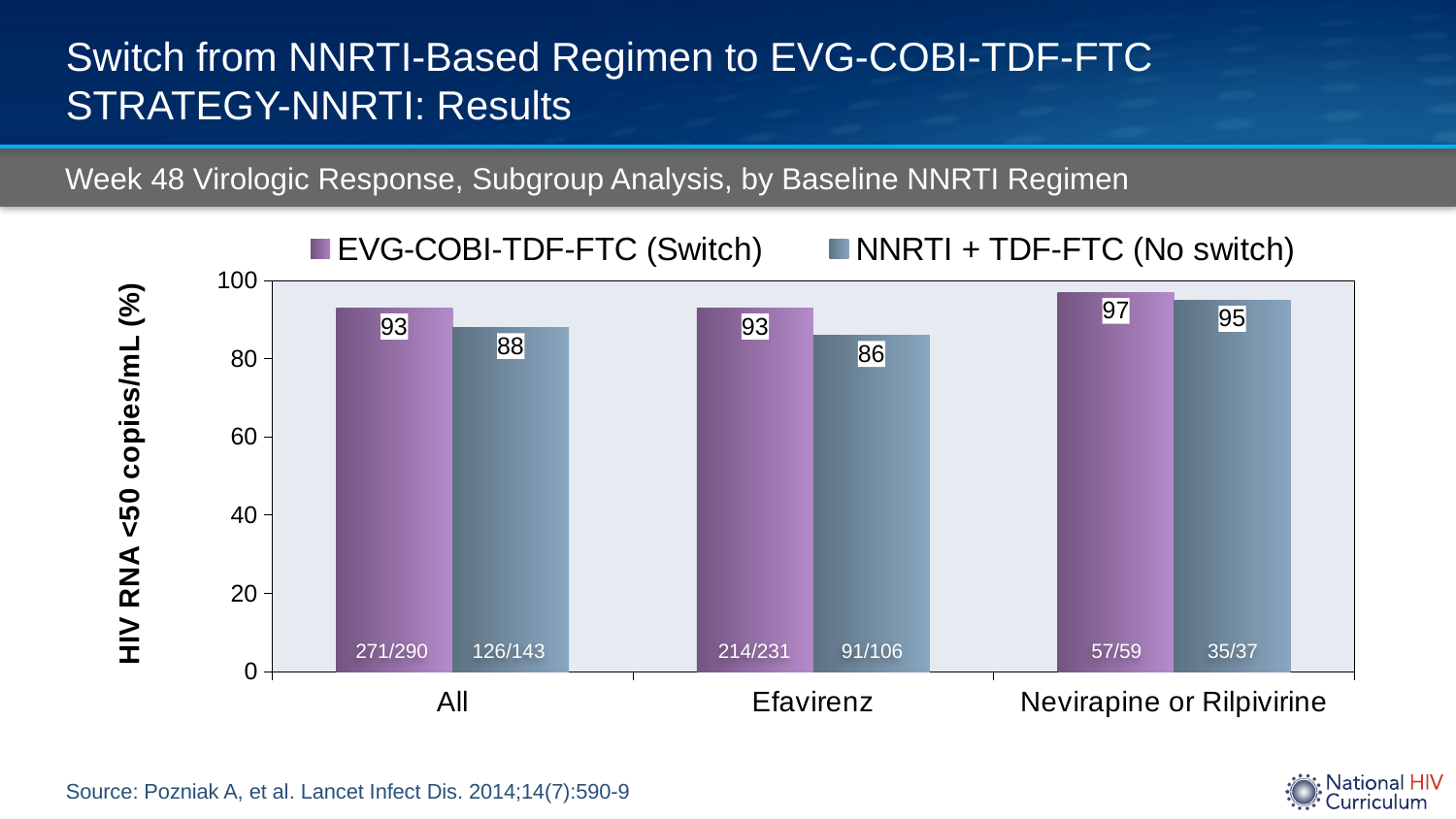
What is the difference between the EVG-COBI-TDF-FTC (Switch) and NNRTI + TDF-FTC (No switch) values in the Efavirenz group? 7 What kind of chart is shown on the slide? Bar chart What is the value for EVG-COBI-TDF-FTC (Switch) in the All group? 93 Which baseline NNRTI group has the lowest value for NNRTI + TDF-FTC (No switch)? Efavirenz What fraction is printed on the NNRTI + TDF-FTC (No switch) bar in the All group? 126/143 What is the value for NNRTI + TDF-FTC (No switch) in the Efavirenz group? 86 Which baseline NNRTI group has the highest value for EVG-COBI-TDF-FTC (Switch)? Nevirapine or Rilpivirine What is the value for NNRTI + TDF-FTC (No switch) in the Nevirapine or Rilpivirine group? 95 What is the difference between the EVG-COBI-TDF-FTC (Switch) and NNRTI + TDF-FTC (No switch) values in the All group? 5 In the Nevirapine or Rilpivirine group, which series has the larger value? EVG-COBI-TDF-FTC (Switch) How many baseline NNRTI groups are shown on the x axis? 3 How many series does the legend list? 2